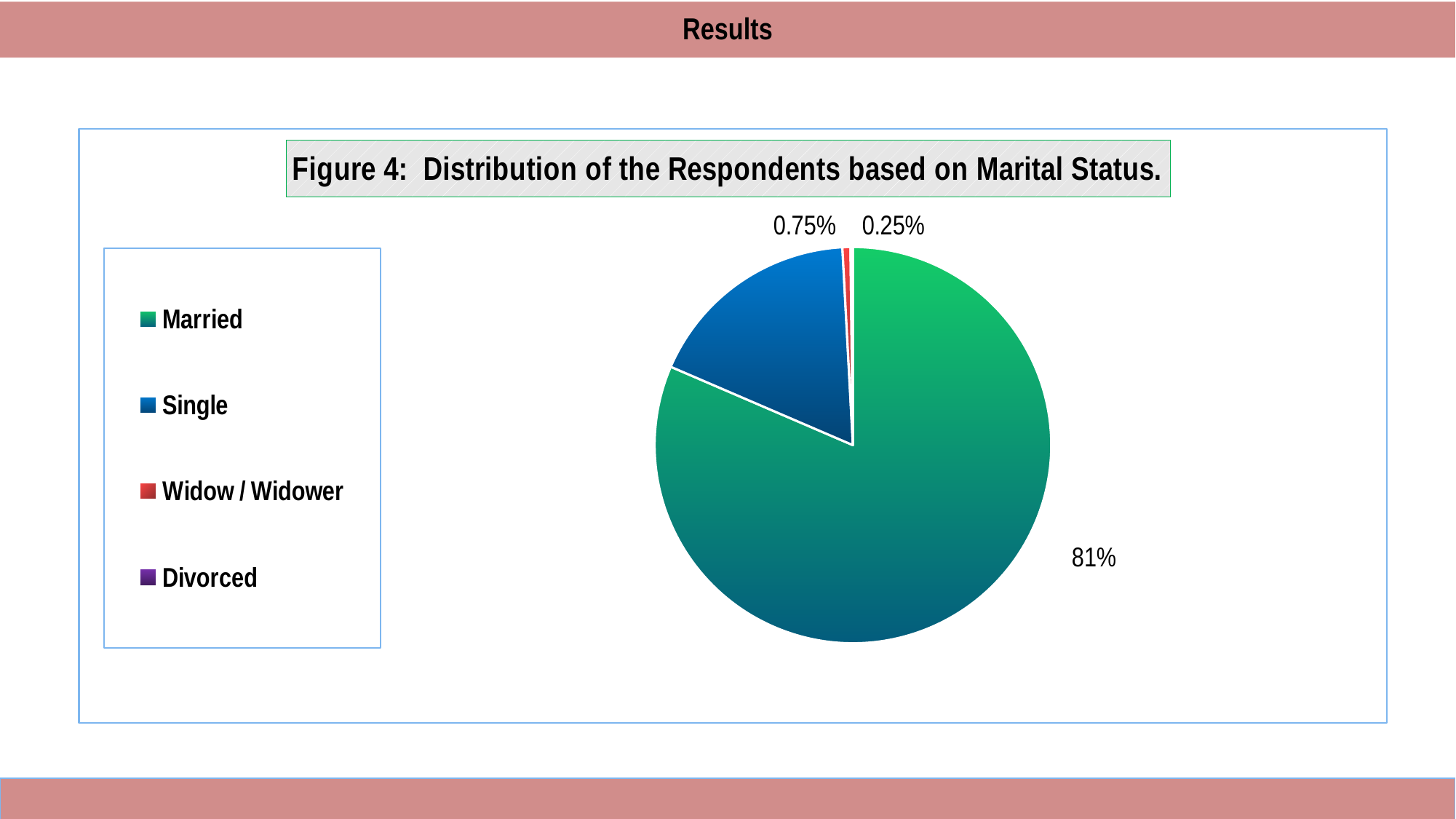
How many marital status categories are listed in the legend? 4 Which marital status category has the smallest share of respondents? Divorced What is the title of the chart? Figure 4: Distribution of the Respondents based on Marital Status. Which colour represents the Single category in the legend? Blue Which category has a larger share, Widow / Widower or Divorced? Widow / Widower What percentage of respondents are Married? 81% What percentage of respondents are Divorced? 0.25% Which marital status category has the largest share of respondents? Married What is the difference in percentage points between the Married and Widow / Widower shares? 80.25% Which category has a larger share, Married or Single? Married What percentage of respondents are Widow / Widower? 0.75% What type of chart is shown on the slide? Pie chart